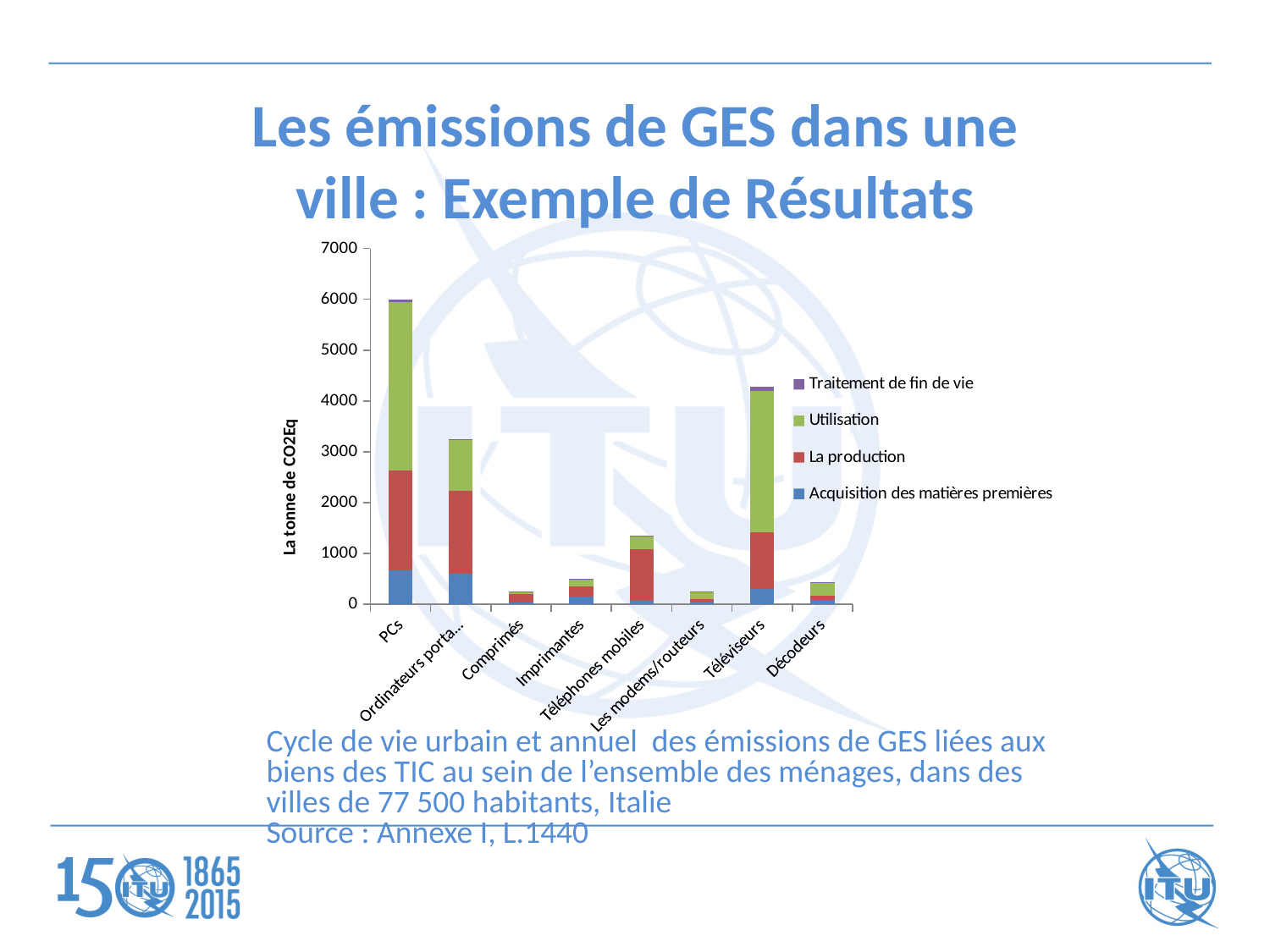
Which has a larger total, PCs or Téléviseurs? PCs How many series does the chart's legend list? 4 Is the total value for Imprimantes greater or less than 1000? less Is the total value for Téléphones mobiles greater or less than 2000? less Is the total value for PCs greater or less than 5000? greater Which has a larger total, Téléphones mobiles or Décodeurs? Téléphones mobiles What kind of chart is shown on the slide? Stacked bar chart Which legend entry is shown in green in the chart? Utilisation What is the label of the chart's vertical axis? La tonne de CO2Eq How many product categories are shown on the x axis of the chart? 8 Which category has the highest total emissions in the chart? PCs